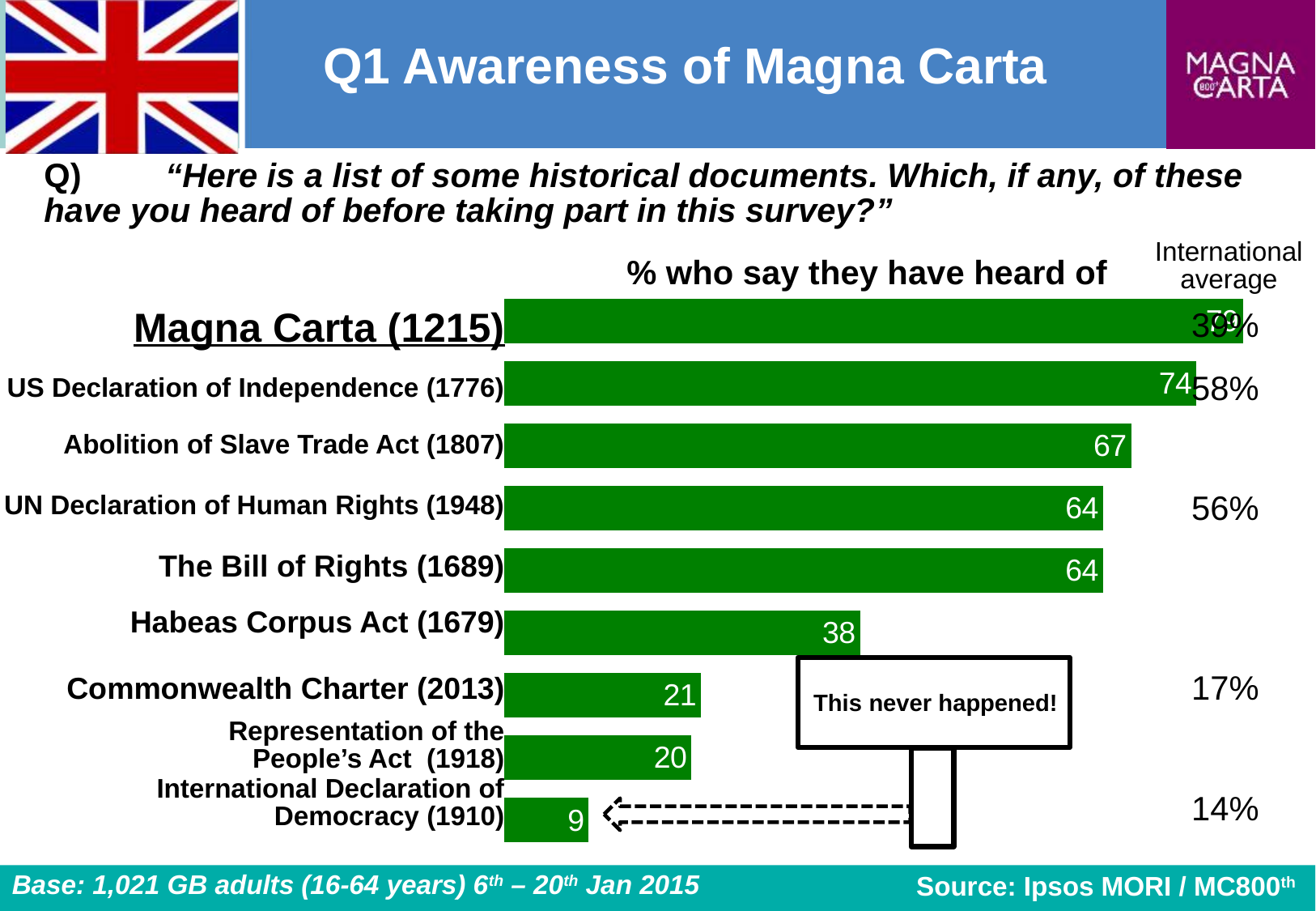
Which has a larger value: the Abolition of Slave Trade Act (1807) or the Habeas Corpus Act (1679)? Abolition of Slave Trade Act (1807) What is the value shown for the Habeas Corpus Act (1679)? 38 What is the title printed above the bars in the chart? % who say they have heard of Which historical document has the lowest value in the chart? International Declaration of Democracy (1910) How many historical documents are listed as categories in the chart? 9 What is the value shown for the Commonwealth Charter (2013)? 21 What is the difference between the values for the US Declaration of Independence (1776) and the Abolition of Slave Trade Act (1807)? 7 What is the value shown for the International Declaration of Democracy (1910)? 9 Which historical document has the longest bar in the chart? Magna Carta (1215) What kind of chart is shown on the slide? bar chart What percentage say they have heard of the US Declaration of Independence (1776)? 74 What is the value shown for the Abolition of Slave Trade Act (1807)? 67